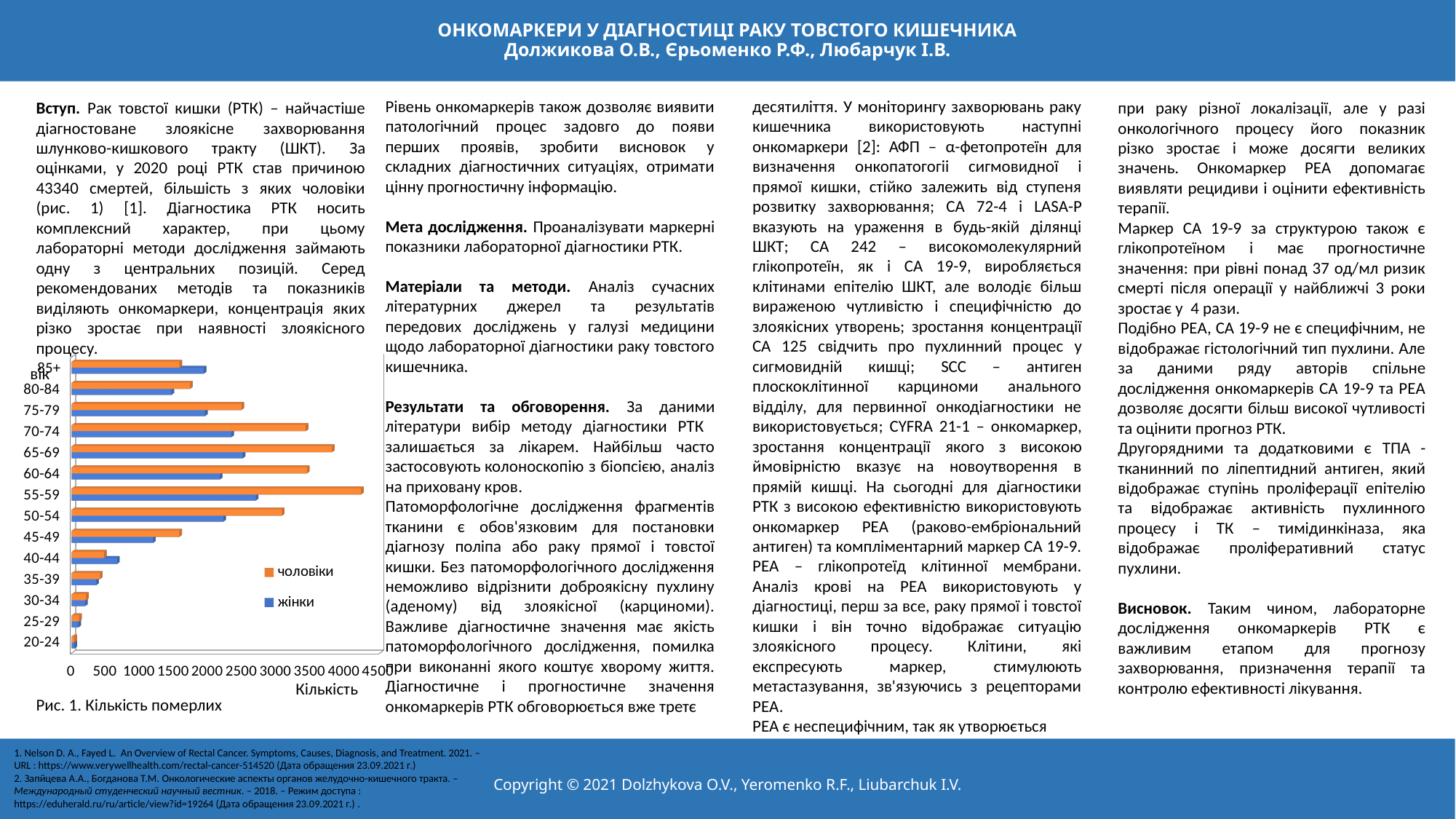
Is the value for жінки in the 60-64 age group greater or less than 2000? greater In the 55-59 age group, which series has the larger value, чоловіки or жінки? чоловіки How many age-group categories are plotted on the chart? 14 Is the value for жінки in the 45-49 age group greater or less than 1500? less Do the values for чоловіки rise or fall from the 20-24 age group to the 55-59 age group? rise How many series does the chart legend list? 2 Is the value for чоловіки in the 55-59 age group greater or less than 4000? greater What kind of chart is shown on the slide? bar chart Which age group has the highest value for чоловіки? 55-59 What is the title of the horizontal axis of the chart? Кількість Which age group has the lowest value for чоловіки? 20-24